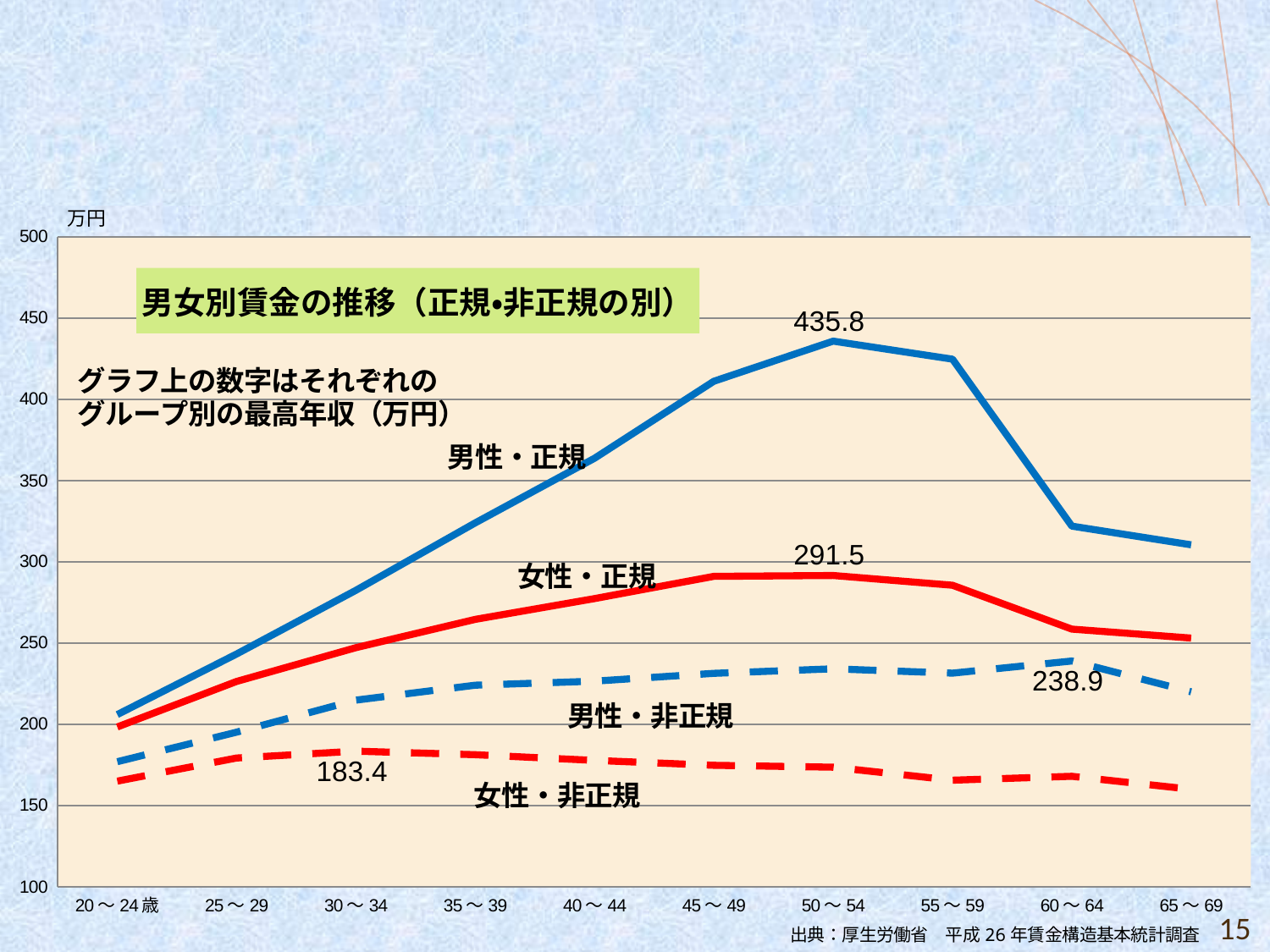
What kind of chart is shown on the slide? line chart How many age groups are shown on the x axis? 10 What is the difference between the peak values of 男性・非正規 and 女性・非正規? 55.5 Which group has the highest peak annual income? 男性・正規 What is the highest annual income shown for 男性・非正規? 238.9 What is the difference between the peak values of 男性・正規 and 女性・正規? 144.3 What is the title of the chart? 男女別賃金の推移（正規・非正規の別） What is the highest annual income shown for 女性・正規? 291.5 What is the highest annual income shown for 男性・正規? 435.8 What is the highest annual income shown for 女性・非正規? 183.4 Is the value for 男性・正規 at 20～24歳 greater or less than 250? less How many lines (series) are plotted on the chart? 4